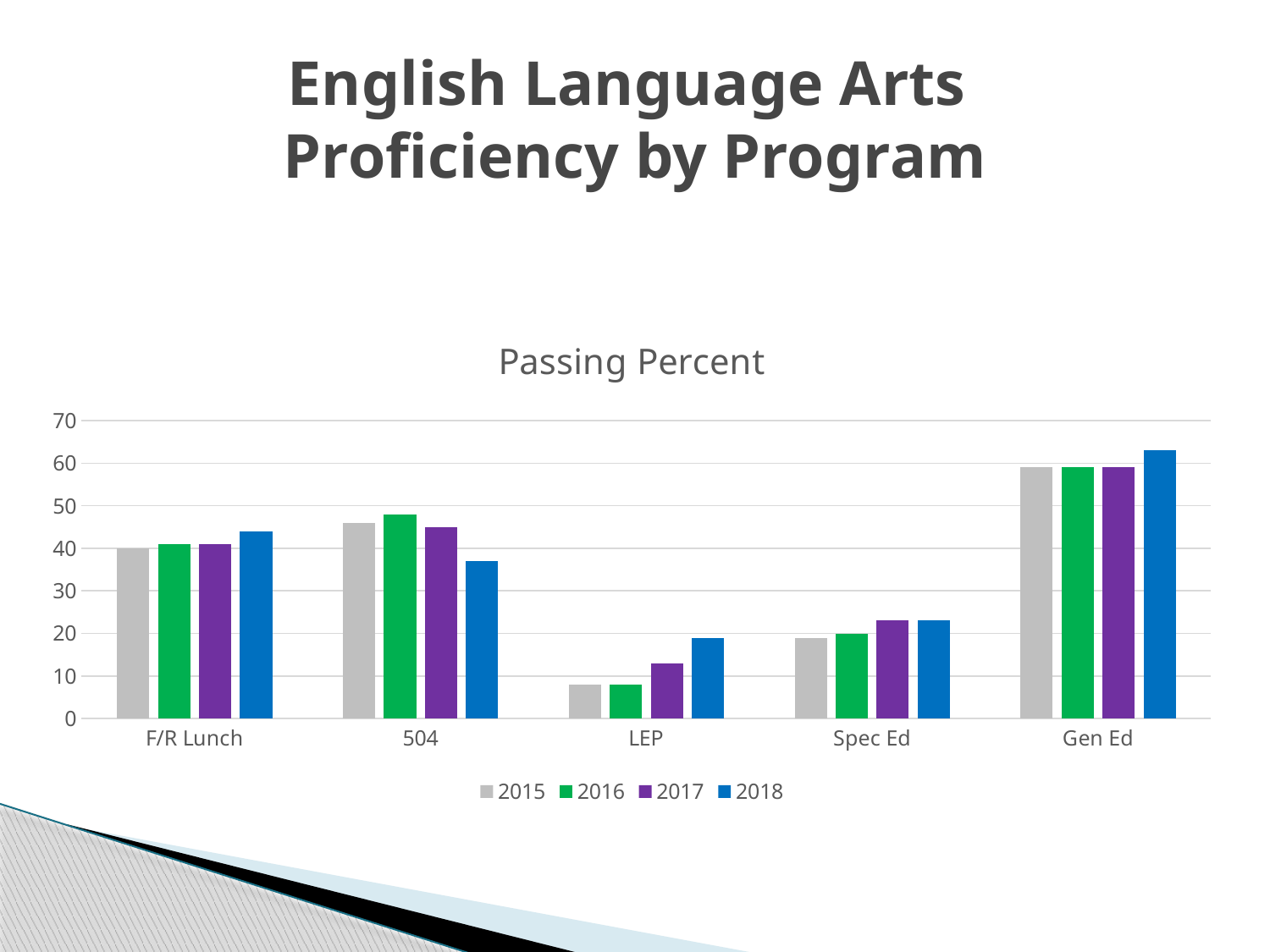
Is the 2018 value for Gen Ed greater or less than 60? greater What is the title of the chart? Passing Percent Is the 2018 value for 504 greater or less than 40? less Which is larger, the 2016 value for 504 or the 2016 value for F/R Lunch? 504 Which program has the highest passing percent for 2018? Gen Ed Do the LEP values rise or fall from 2015 to 2018? rise Is the 2018 value for LEP greater or less than 10? greater What kind of chart is shown on the slide? bar chart Which is larger for Gen Ed, the 2015 value or the 2018 value? 2018 How many program categories are shown on the x axis? 5 Which program has the lowest passing percent for 2015? LEP How many series does the legend list? 4